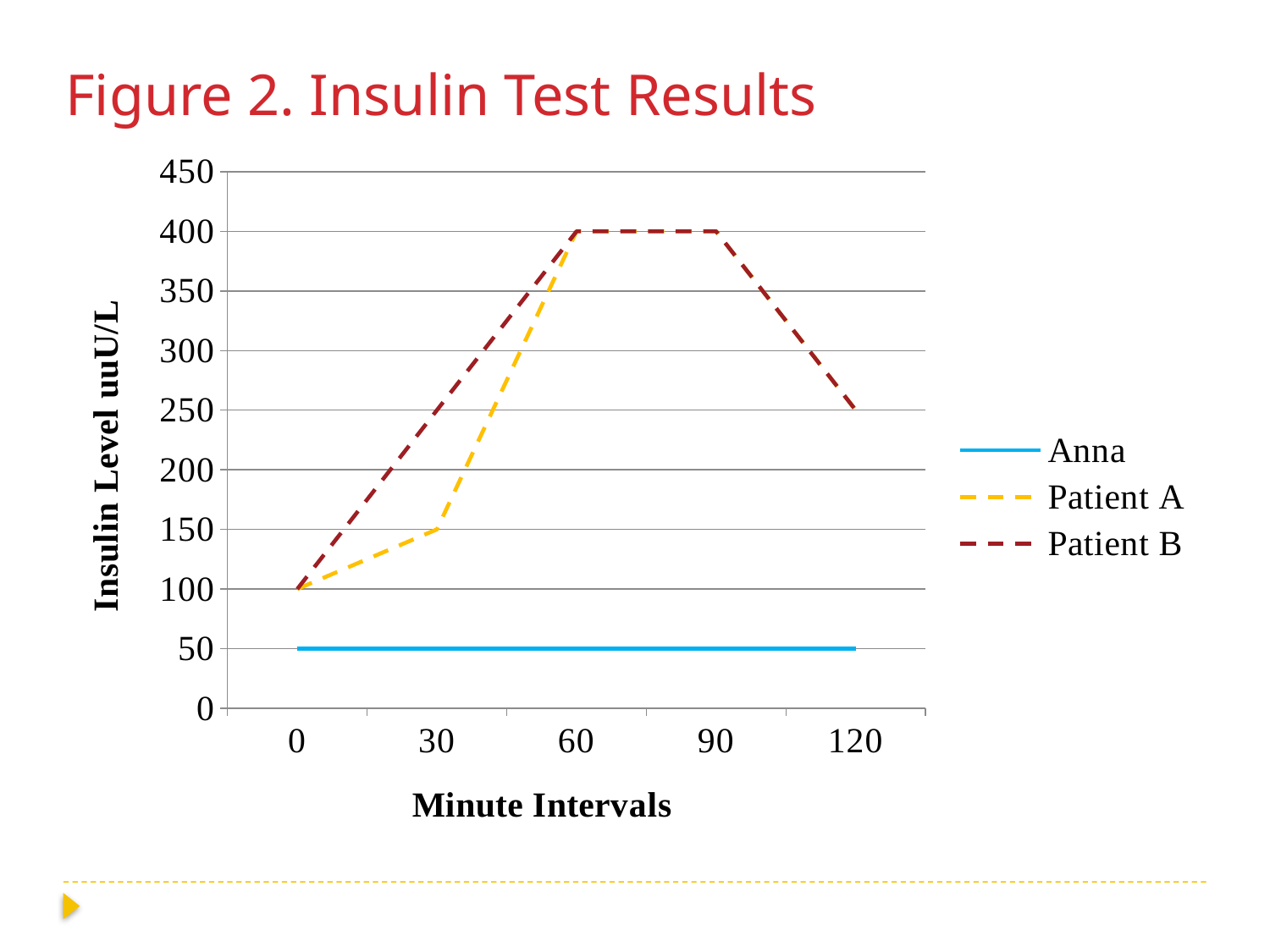
How many series does the legend list? 3 Which series has the highest insulin level at 30 minutes? Patient B What is Patient B's insulin level at 60 minutes? 400 Is Patient B's insulin level at 30 minutes greater or less than 200? greater What is the title of the x axis? Minute Intervals What kind of chart is shown on the slide? line chart How does Anna's insulin level change across the minute intervals? It stays constant Which series has the lowest insulin level at 0 minutes? Anna By how much does Patient A's insulin level increase from 0 to 60 minutes? 300 What is Anna's insulin level at 60 minutes? 50 What is Patient A's insulin level at 30 minutes? 150 What is Patient B's insulin level at 120 minutes? 250